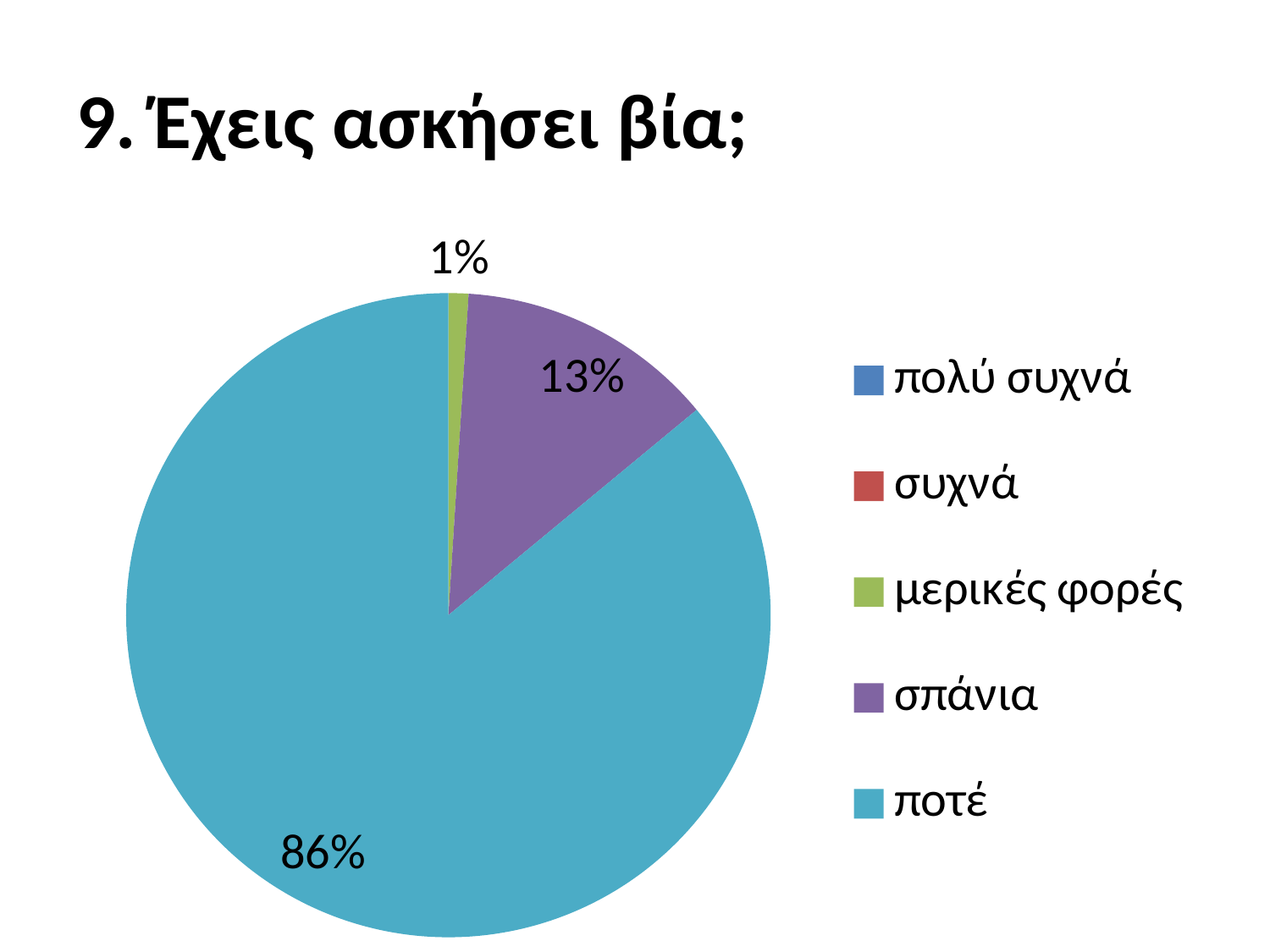
Which is larger, the slice for σπάνια or the slice for μερικές φορές? σπάνια What is the difference in percentage points between ποτέ and σπάνια? 73 What value is shown for μερικές φορές? 1% What is the title of the slide? 9. Έχεις ασκήσει βία; Which category has the largest slice of the pie? ποτέ What type of chart is shown on the slide? pie chart What is the difference in percentage points between σπάνια and μερικές φορές? 12 How many categories does the legend list? 5 What value is shown for σπάνια? 13% What percentage of the pie is the ποτέ slice? 86% What colour is the ποτέ slice in the pie chart? teal (blue-green) Which category has the smallest printed percentage on the pie? μερικές φορές